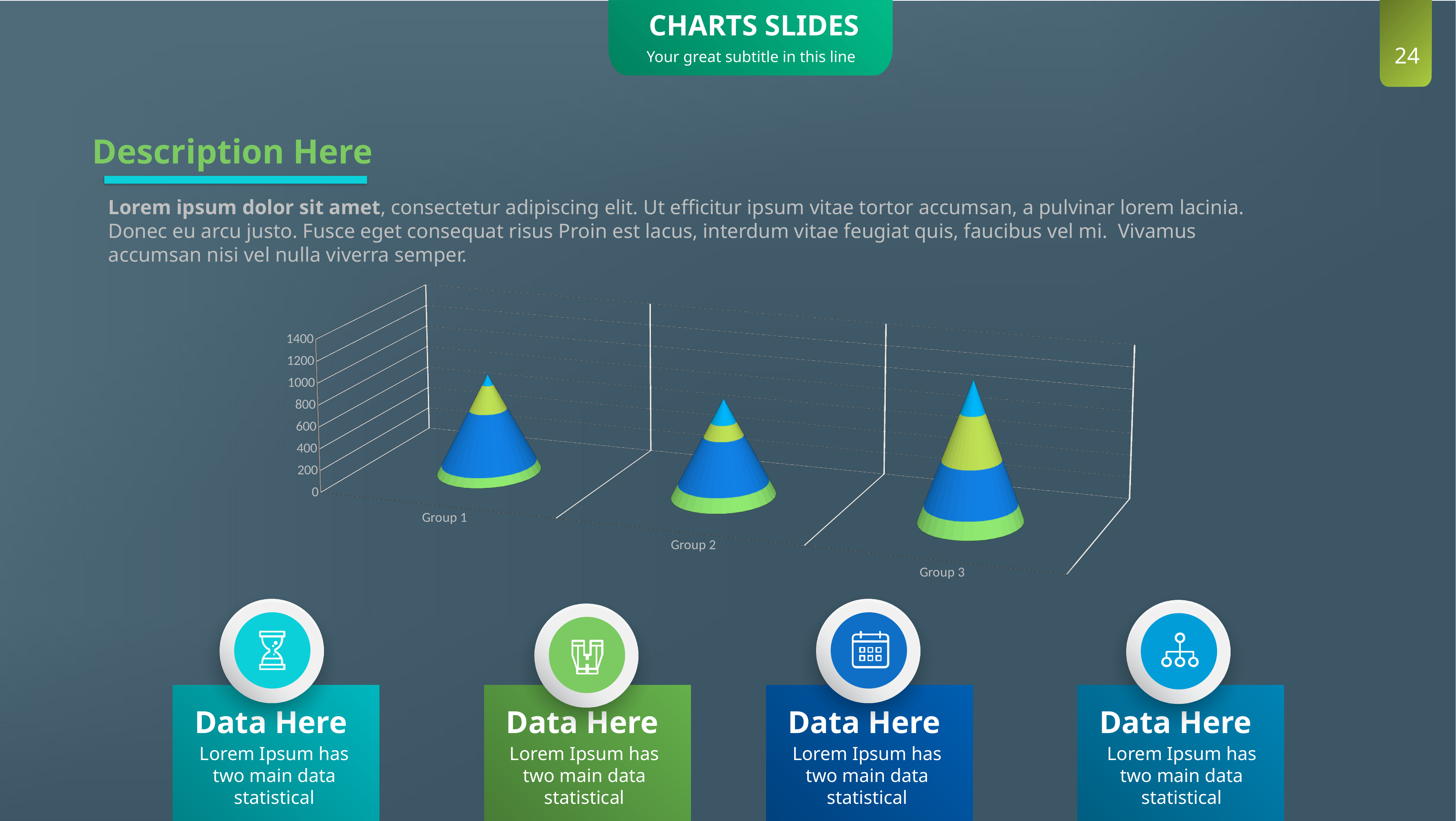
Which group has the tallest cone on the chart? Group 3 What kind of chart is shown on the slide? bar chart What is the label of the first category on the chart's horizontal axis? Group 1 Is the value for Group 3 greater or less than 400? greater Is the total for Group 3 larger or smaller than the total for Group 1? larger How many groups (categories) are plotted on the chart? 3 Is the total for Group 3 larger or smaller than the total for Group 2? larger What is the highest value shown on the vertical axis of the chart? 1400 Is the value for Group 1 greater or less than 200? greater